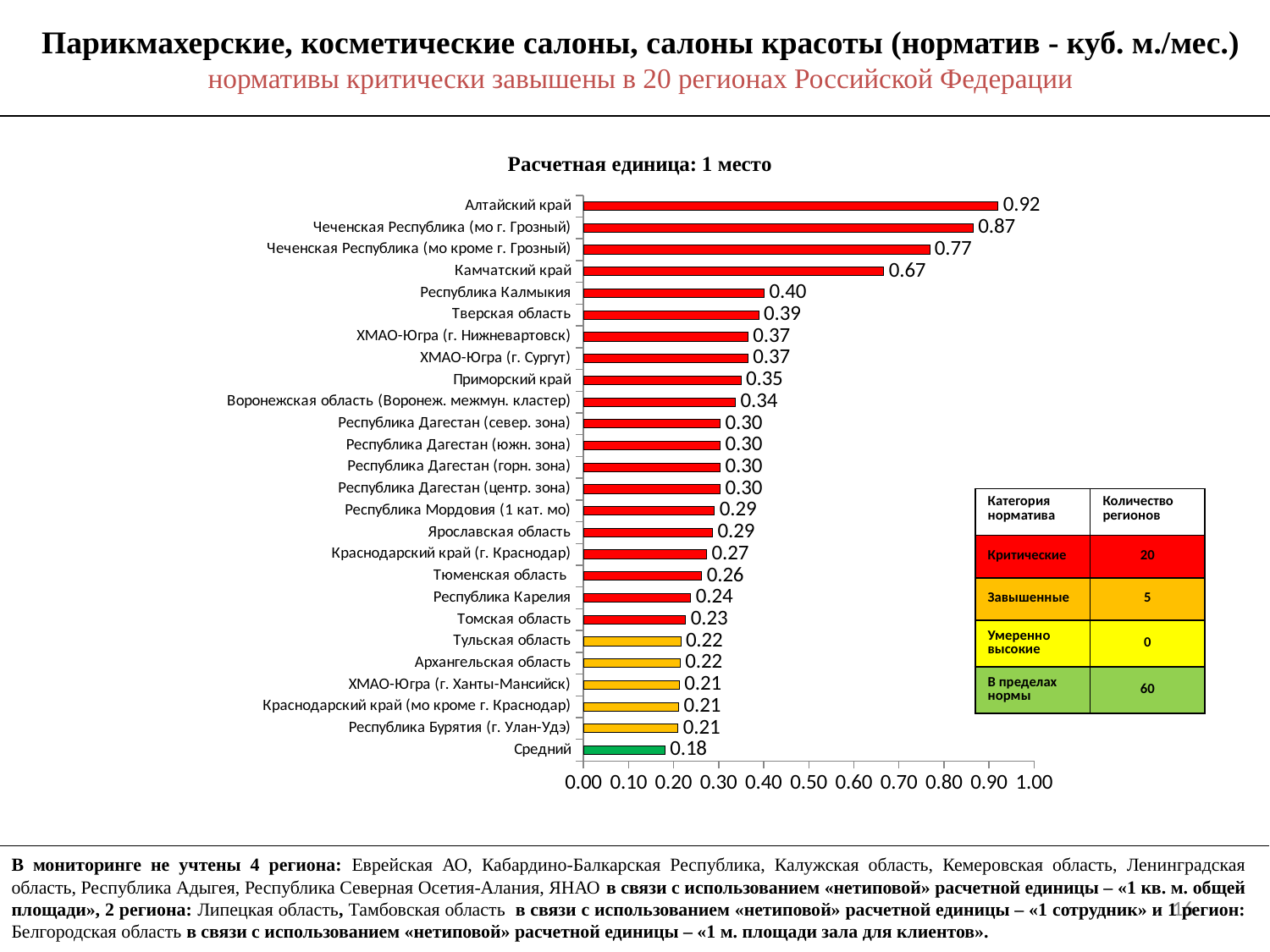
What is the title of the chart? Расчетная единица: 1 место What is the value for Алтайский край? 0.92 What is the difference between the values for Камчатский край and Средний? 0.49 What is the difference between the values for Алтайский край and Чеченская Республика (мо г. Грозный)? 0.05 Which category has the lowest value? Средний What is the value for Камчатский край? 0.67 Which is larger, the value for Республика Калмыкия or the value for Тверская область? Республика Калмыкия What is the value for Тюменская область? 0.26 What is the value for Средний? 0.18 How many bars are shown in the chart? 26 What kind of chart is shown on the slide? Bar chart Which category has the highest value? Алтайский край